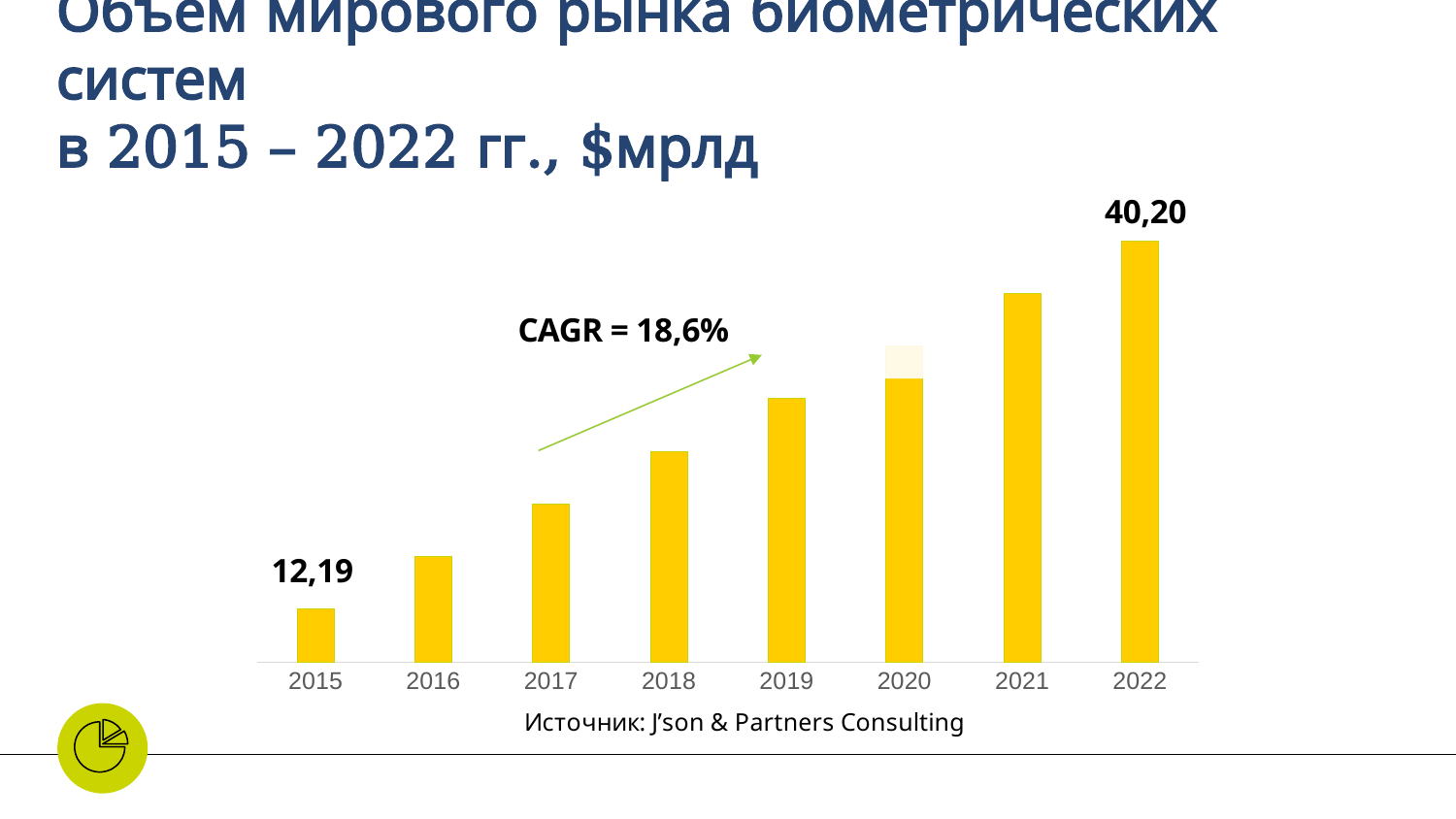
What is the value for 2015? 12,19 Which is larger, the value for 2018 or the value for 2020? 2020 What CAGR value is annotated on the chart? 18,6% What is the difference between the values for 2022 and 2015? 28,01 How many years are shown on the x axis? 8 Which is larger, the value for 2016 or the value for 2021? 2021 Which year has the lowest value? 2015 What kind of chart is shown on the slide? bar chart Which year has the highest value? 2022 Do the values rise or fall from 2015 to 2022? rise What is the value for 2022? 40,20 What source is cited below the chart? J'son & Partners Consulting